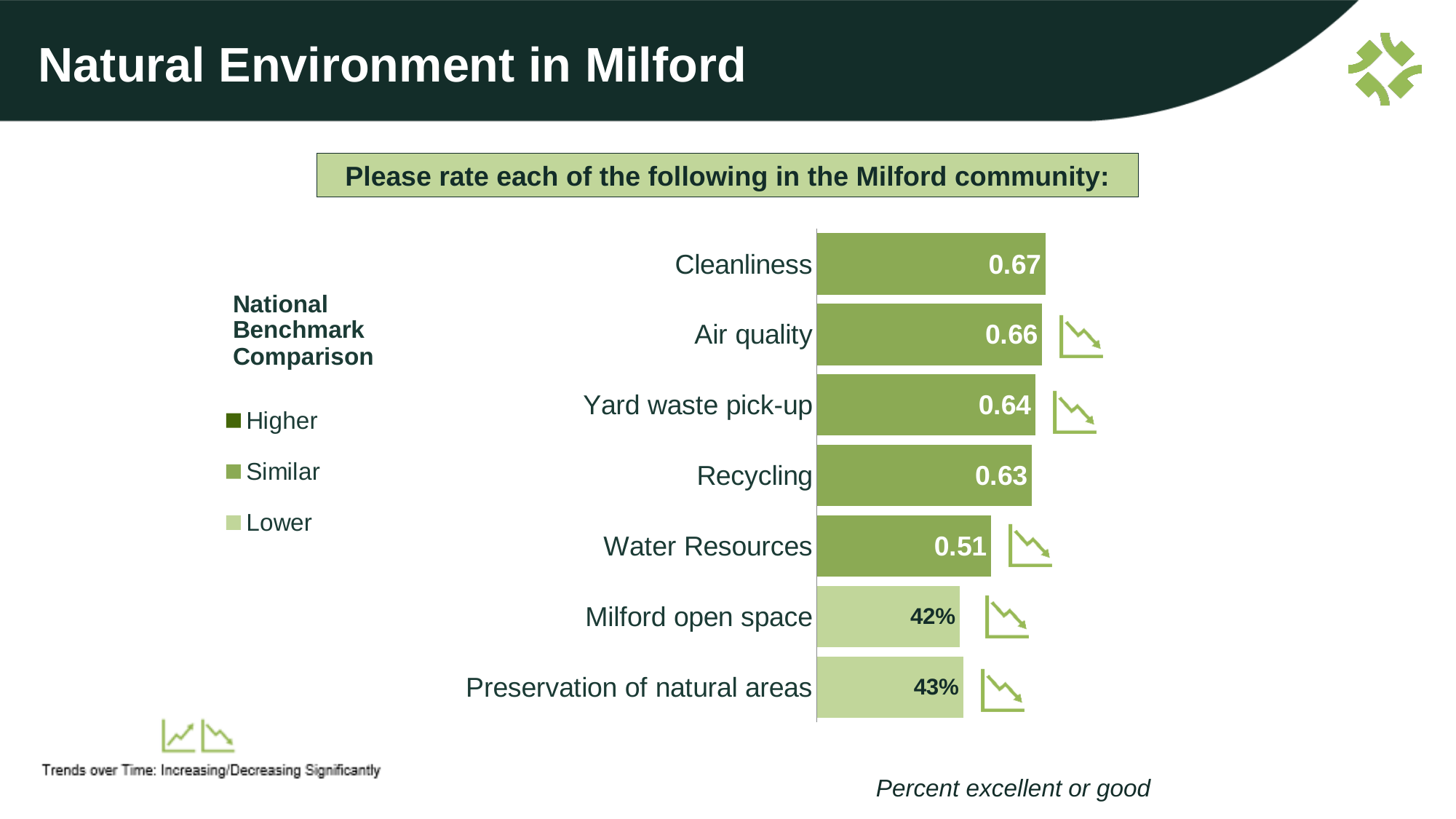
Which has a larger value, Yard waste pick-up or Water Resources? Yard waste pick-up How many categories are shown in the chart? 7 What is the difference between the values for Preservation of natural areas and Milford open space? 1% What is the value shown for Preservation of natural areas? 43% What is the value shown for Water Resources? 0.51 How many entries does the National Benchmark Comparison legend list? 3 What is the difference between the values for Cleanliness and Recycling? 0.04 What is the value shown for Cleanliness? 0.67 What is the value shown for Milford open space? 42% Which category has the lowest value in the chart? Milford open space Which category has the highest value in the chart? Cleanliness What kind of chart is shown on the slide? Bar chart